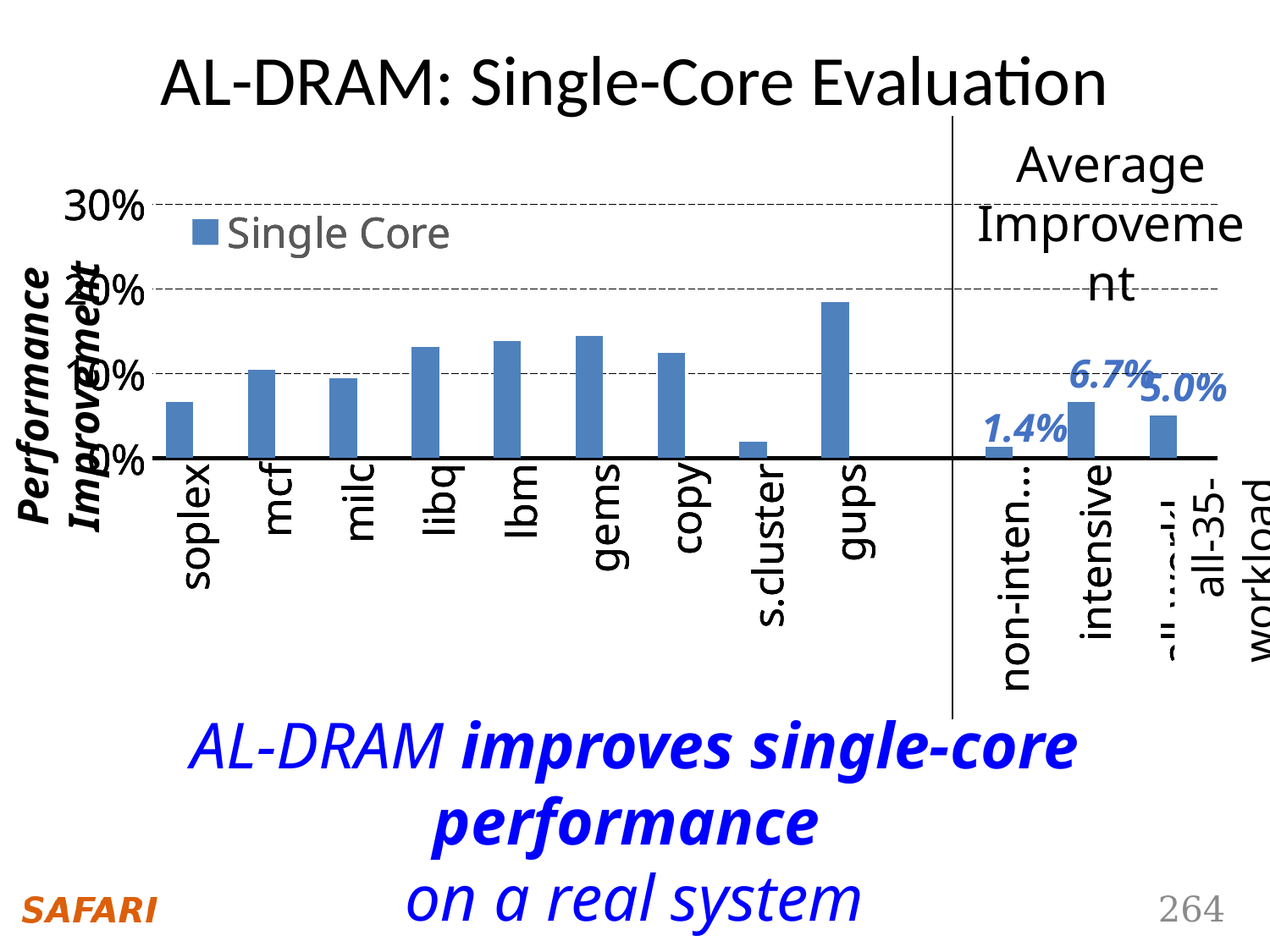
Which has a larger performance improvement, gups or mcf? gups Among the nine individual benchmarks (soplex through gups), which has the lowest performance improvement? s.cluster What is the name of the series shown in the legend? Single Core What is the difference between the average improvement for intensive workloads and for non-intensive workloads? 5.3% Is the performance improvement for soplex greater or less than 10%? less How many series does the legend list? 1 What is the average performance improvement for the intensive workloads? 6.7% Which benchmark has the highest single-core performance improvement? gups Is the performance improvement for gups greater or less than 10%? greater What is the average performance improvement for the all-35-workload group? 5.0% What is the average performance improvement for the non-intensive workloads? 1.4% What type of chart is shown on the slide? bar chart